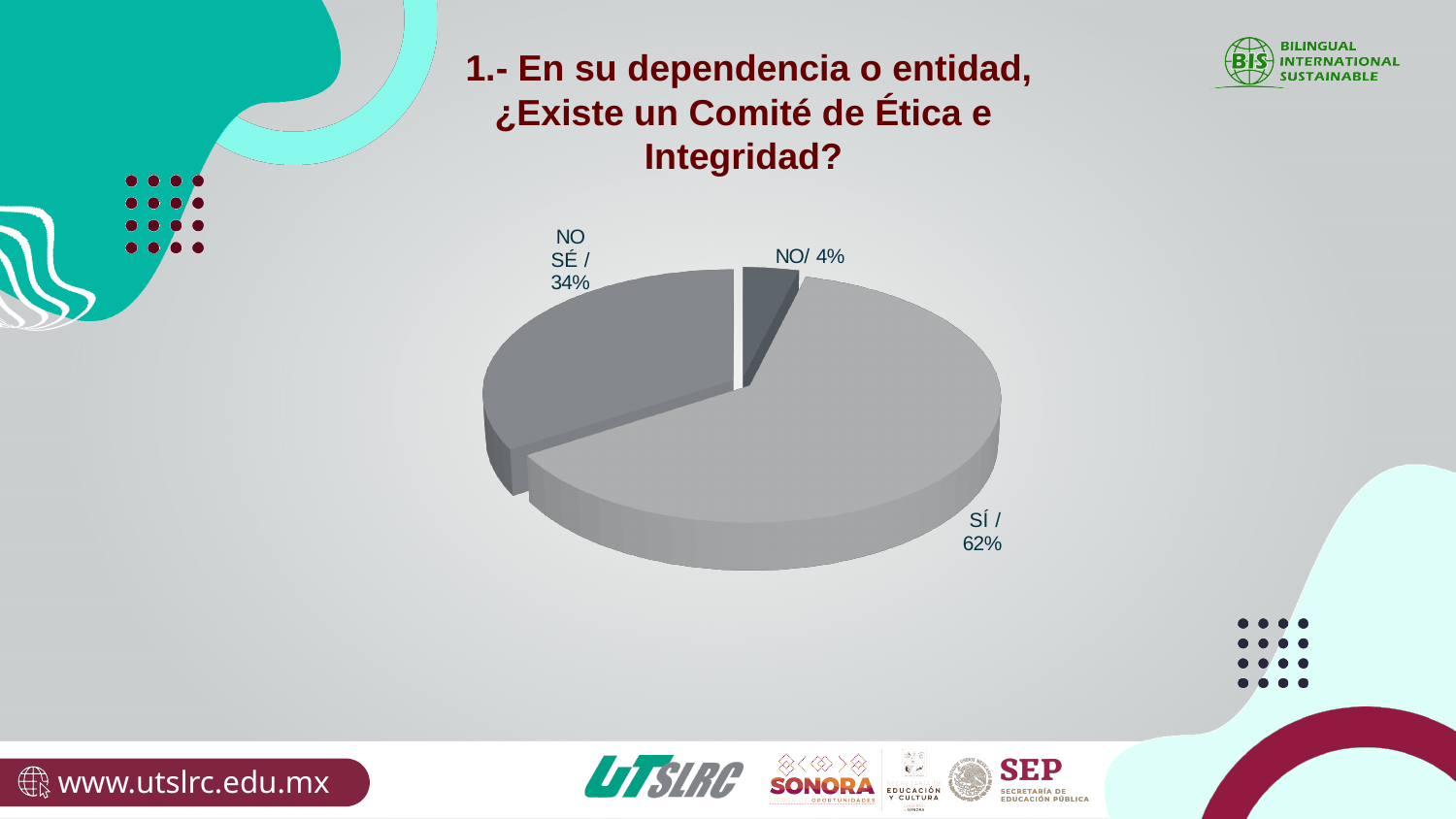
What percentage of respondents answered SÍ? 62% Which response has the smallest share of the pie? NO What is the difference in percentage points between the NO SÉ and NO slices? 30 What percentage of respondents answered NO? 4% Which is larger, the share for NO SÉ or the share for NO? NO SÉ What is the combined share of the NO and NO SÉ slices? 38% What question does the chart title ask? 1.- En su dependencia o entidad, ¿Existe un Comité de Ética e Integridad? What kind of chart is shown on the slide? Pie chart Which response has the largest share of the pie? SÍ What is the difference in percentage points between the SÍ and NO SÉ slices? 28 What percentage of respondents answered NO SÉ? 34% How many slices does the pie chart have? 3